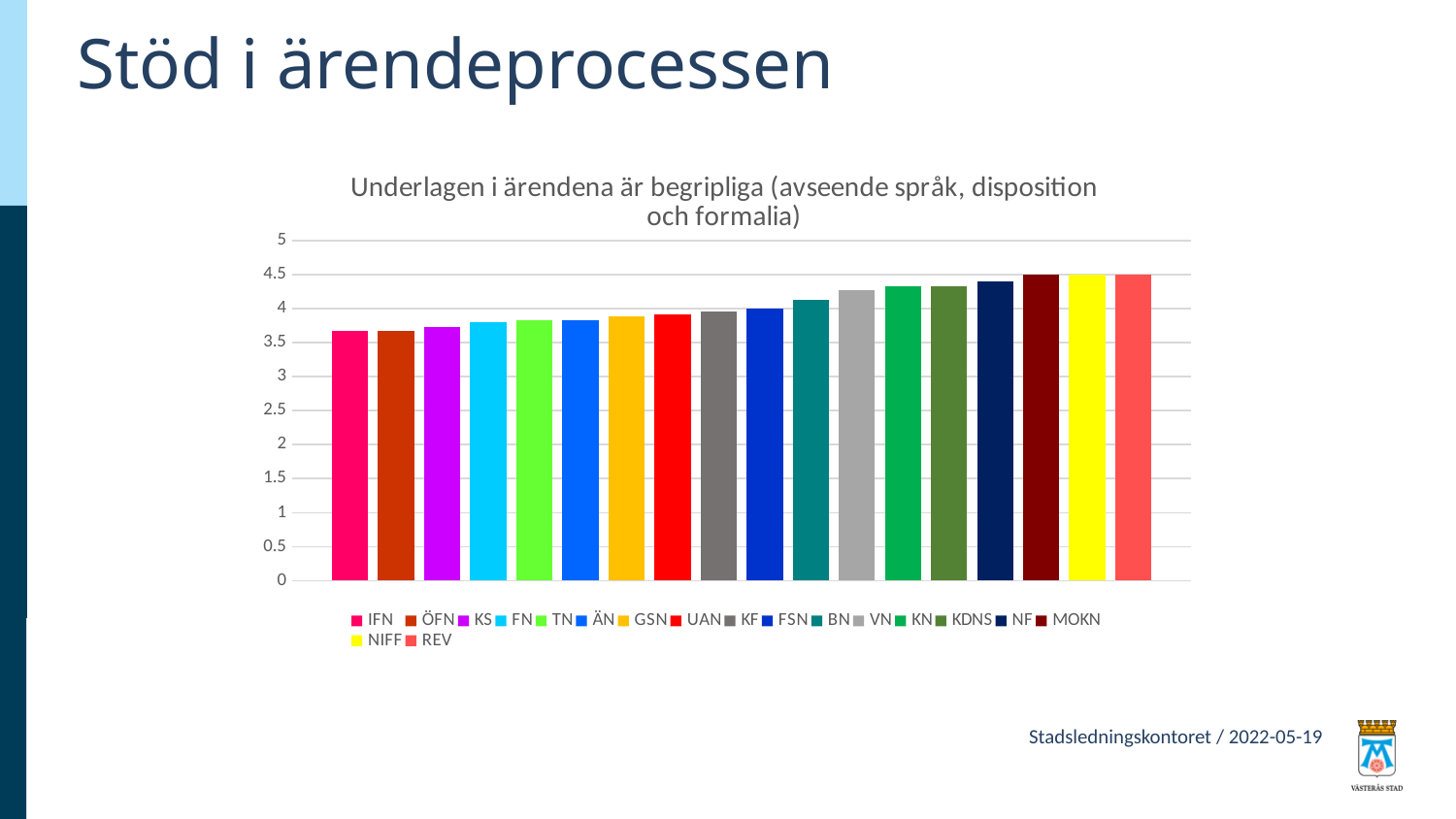
Which has the larger value, KN or KS? KN How many entries does the chart legend list? 18 Is the value for VN greater or less than 4? greater How many bars are plotted in the chart? 18 Do the bar values rise or fall from left to right across the chart? Rise Is the value for FN greater or less than 4? less What is the title of the chart? Underlagen i ärendena är begripliga (avseende språk, disposition och formalia) Is the value for IFN greater or less than 4? less What kind of chart is shown on the slide? Bar chart Which has the larger value, REV or IFN? REV